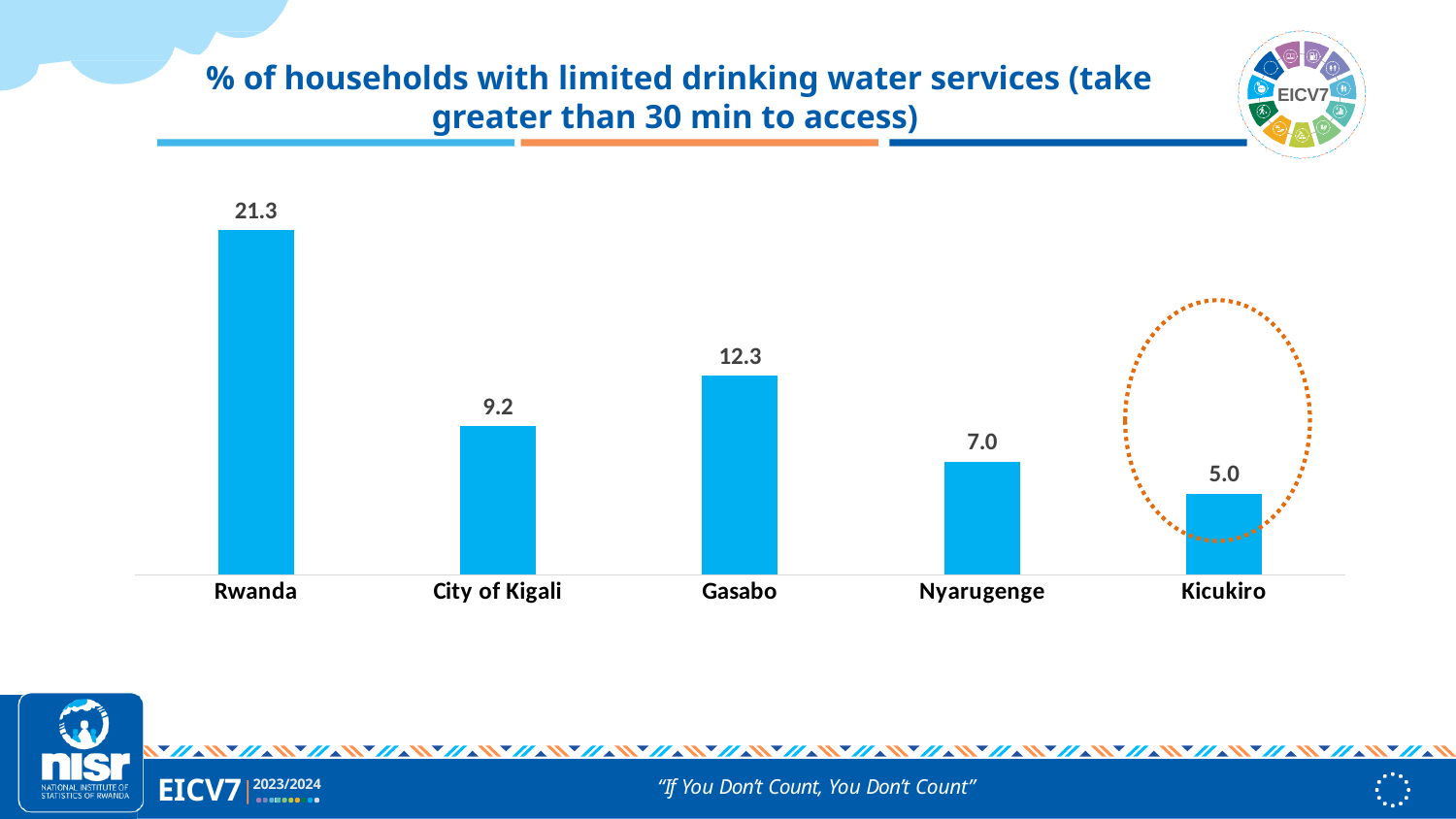
What is the value for Kicukiro? 5.0 What is the value for City of Kigali? 9.2 What is the value for Gasabo? 12.3 What is the value for Nyarugenge? 7.0 What is the difference between the values for Gasabo and Kicukiro? 7.3 Which is larger, the value for Gasabo or the value for Nyarugenge? Gasabo What kind of chart is shown on the slide? Bar chart What is the value for Rwanda? 21.3 Which category has the highest value? Rwanda Which category has the lowest value? Kicukiro What is the difference between the values for Rwanda and City of Kigali? 12.1 How many categories are shown on the chart? 5